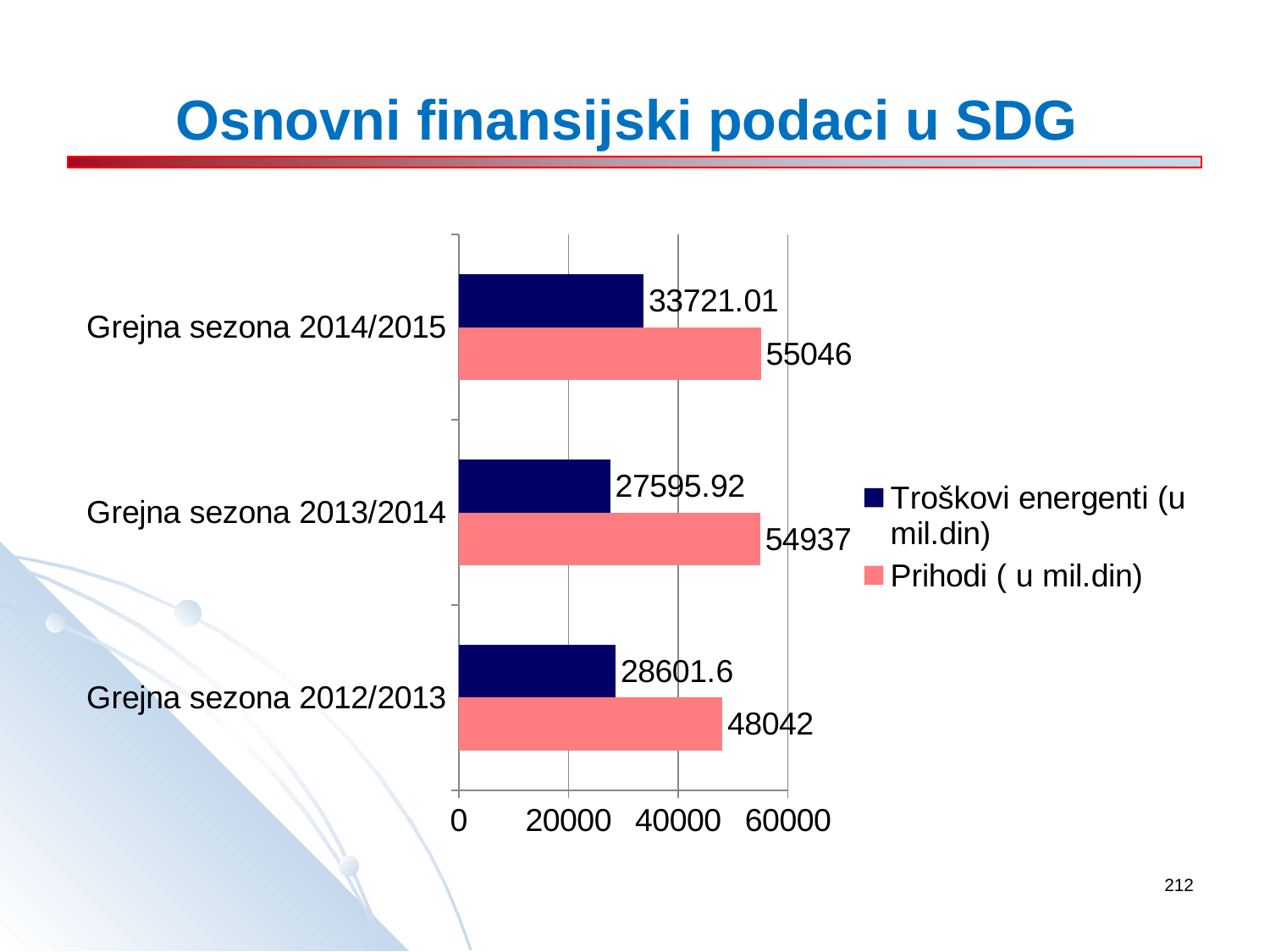
What is the value of Troškovi energenti (u mil.din) for Grejna sezona 2012/2013? 28601.6 Which heating season has the highest Troškovi energenti (u mil.din)? Grejna sezona 2014/2015 How many heating seasons are shown on the chart? 3 What is the difference between Prihodi ( u mil.din) for Grejna sezona 2014/2015 and Grejna sezona 2013/2014? 109 What is the difference between Prihodi ( u mil.din) for Grejna sezona 2013/2014 and Grejna sezona 2012/2013? 6895 Which heating season has the lowest Prihodi ( u mil.din)? Grejna sezona 2012/2013 What is the value of Prihodi ( u mil.din) for Grejna sezona 2014/2015? 55046 What is the value of Prihodi ( u mil.din) for Grejna sezona 2012/2013? 48042 What type of chart is shown on the slide? Bar chart Which is larger for Grejna sezona 2014/2015: Troškovi energenti (u mil.din) or Prihodi ( u mil.din)? Prihodi ( u mil.din) How many series does the legend list? 2 What is the value of Troškovi energenti (u mil.din) for Grejna sezona 2013/2014? 27595.92